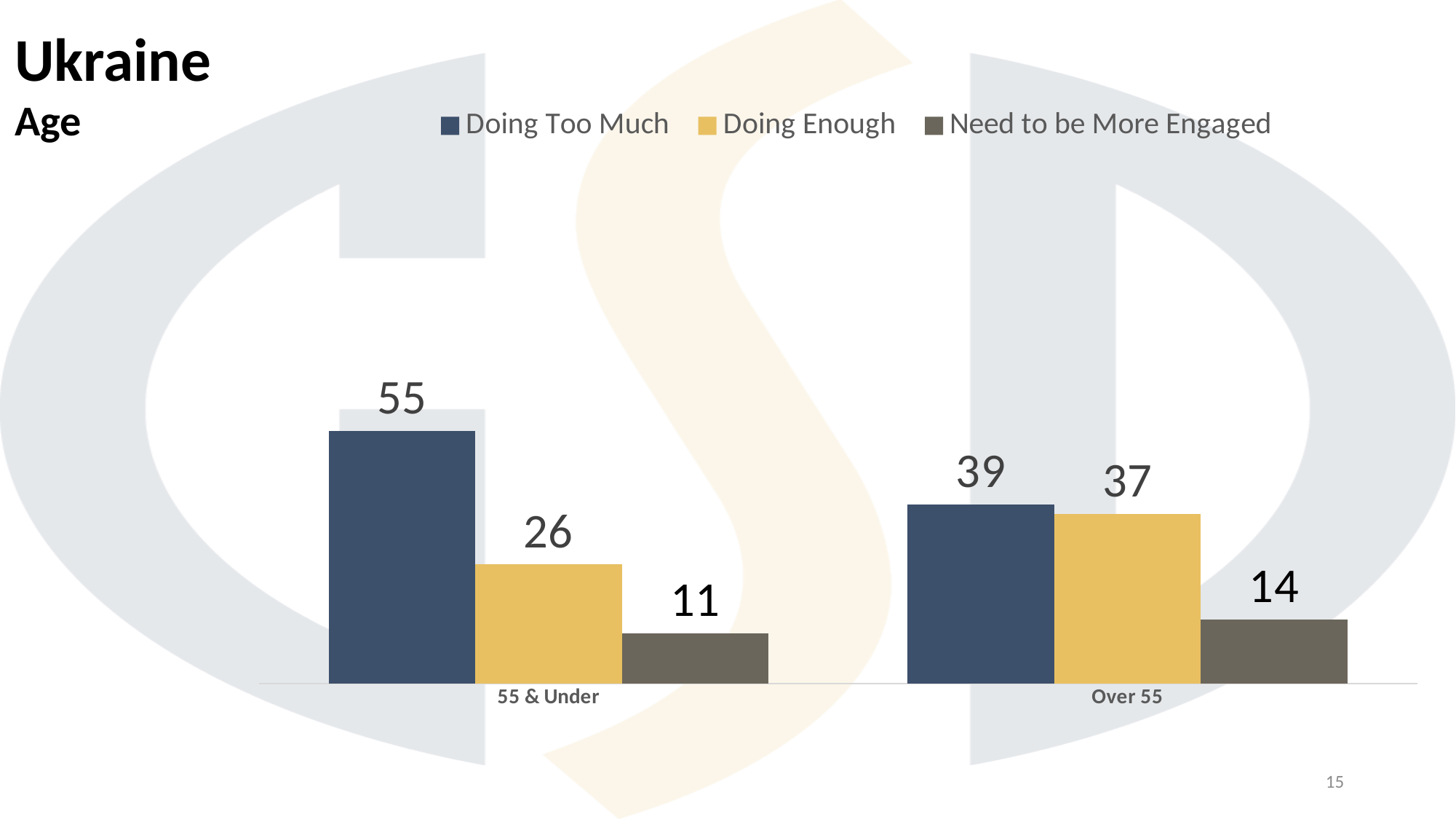
Which series has the highest value in the "55 & Under" group? Doing Too Much What is the value for "Doing Too Much" in the "55 & Under" group? 55 What is the difference between "Doing Too Much" and "Doing Enough" in the "55 & Under" group? 29 What kind of chart is shown on the slide? Bar chart Which is larger: "Doing Enough" for "55 & Under" or "Doing Enough" for "Over 55"? Over 55 How many series does the legend list? 3 What is the value for "Need to be More Engaged" in the "55 & Under" group? 11 How many age categories are shown on the x axis? 2 What is the value for "Doing Enough" in the "Over 55" group? 37 What is the difference between the "Doing Too Much" values for "55 & Under" and "Over 55"? 16 What is the value for "Doing Too Much" in the "Over 55" group? 39 Which series has the lowest value in the "Over 55" group? Need to be More Engaged